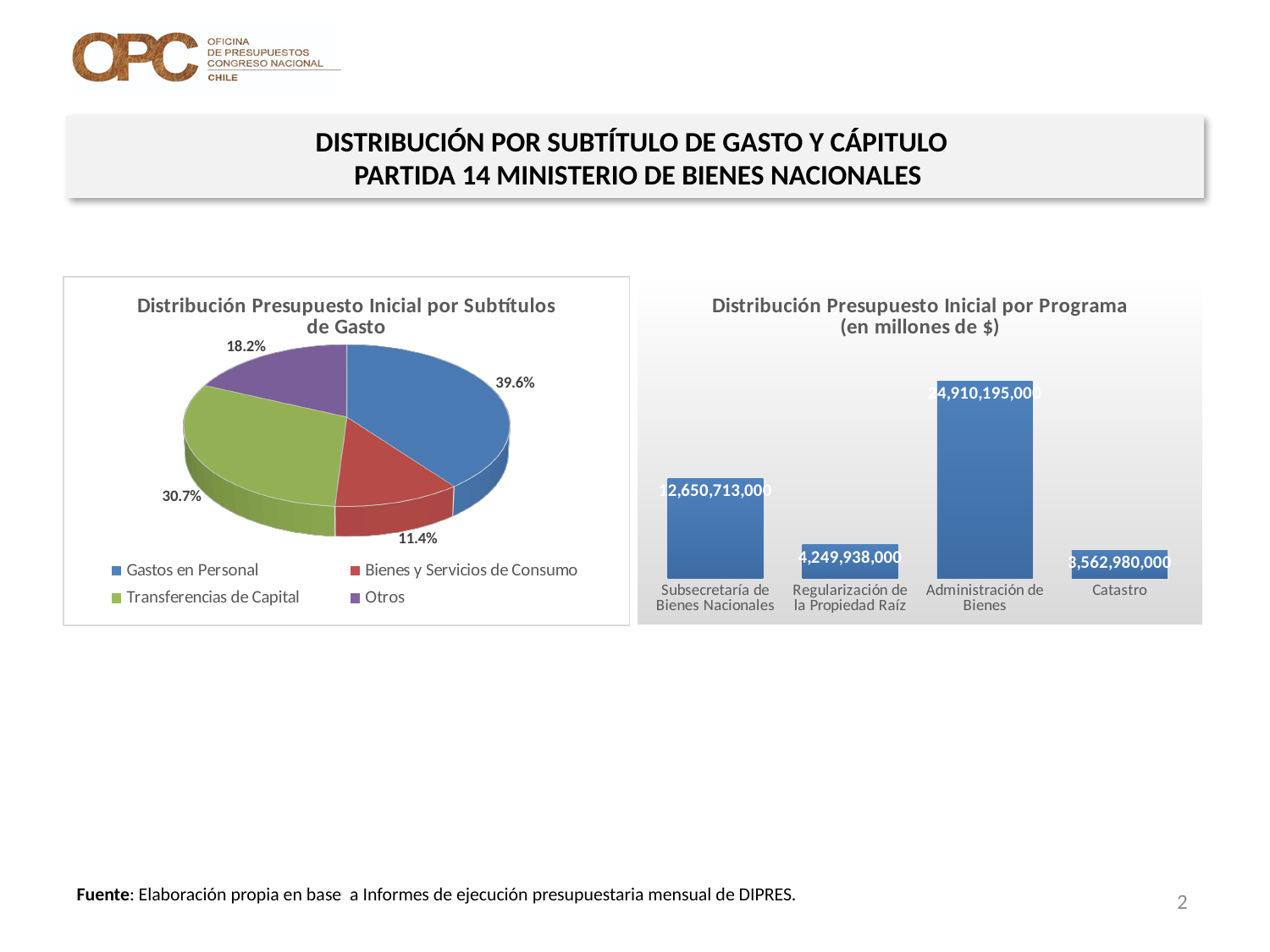
In the pie chart 'Distribución Presupuesto Inicial por Subtítulos de Gasto', what is the difference in percentage points between Otros and Bienes y Servicios de Consumo? 6.8 In the pie chart 'Distribución Presupuesto Inicial por Subtítulos de Gasto', what share does Bienes y Servicios de Consumo have? 11.4% In the pie chart 'Distribución Presupuesto Inicial por Subtítulos de Gasto', what share does Gastos en Personal have? 39.6% In the pie chart 'Distribución Presupuesto Inicial por Subtítulos de Gasto', how many categories does the legend list? 4 What type of chart is the chart on the right, 'Distribución Presupuesto Inicial por Programa'? Bar chart In the pie chart 'Distribución Presupuesto Inicial por Subtítulos de Gasto', which category has the smallest share? Bienes y Servicios de Consumo In the bar chart 'Distribución Presupuesto Inicial por Programa', which program has the lowest value? Catastro In the bar chart 'Distribución Presupuesto Inicial por Programa', what is the value for Administración de Bienes? 24,910,195,000 In the pie chart 'Distribución Presupuesto Inicial por Subtítulos de Gasto', which category has the largest share? Gastos en Personal In the bar chart 'Distribución Presupuesto Inicial por Programa', which is larger: Subsecretaría de Bienes Nacionales or Regularización de la Propiedad Raíz? Subsecretaría de Bienes Nacionales In the bar chart 'Distribución Presupuesto Inicial por Programa', what is the value for Regularización de la Propiedad Raíz? 4,249,938,000 In the pie chart 'Distribución Presupuesto Inicial por Subtítulos de Gasto', what share does Transferencias de Capital have? 30.7%